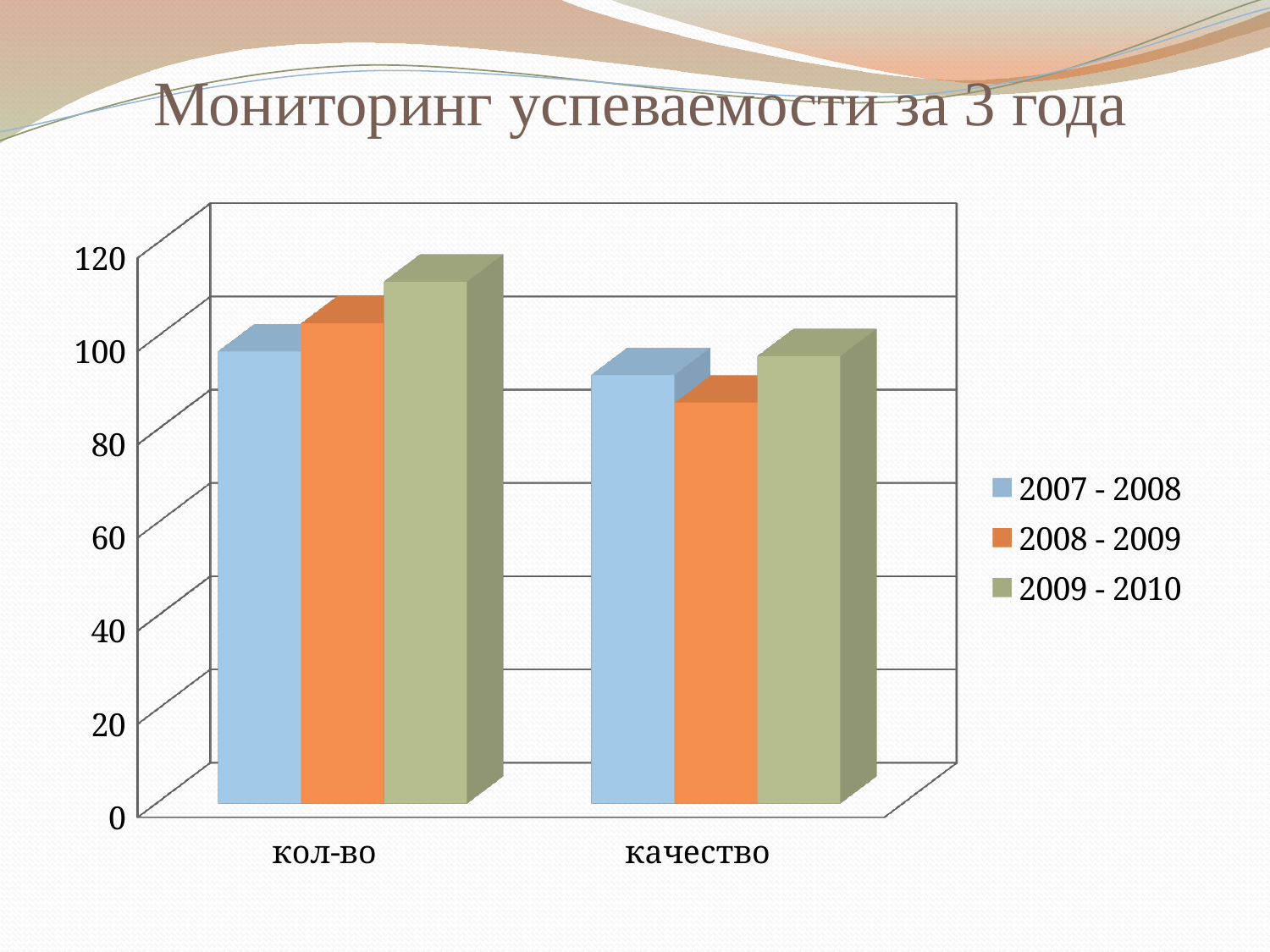
What kind of chart is shown on the slide? bar chart Which series has the highest value for качество? 2009 - 2010 How many series does the legend list? 3 For the 2008 - 2009 series, which is larger: кол-во or качество? кол-во What is the title of the chart on the slide? Мониторинг успеваемости за 3 года Is the value for кол-во in 2009 - 2010 greater or less than 100? greater How many categories are shown on the x axis? 2 Which series has the lowest value for кол-во? 2007 - 2008 Which series has the lowest value for качество? 2008 - 2009 Which series has the highest value for кол-во? 2009 - 2010 Is the value for качество in 2008 - 2009 greater or less than 100? less Is the value for качество in 2007 - 2008 greater or less than 80? greater